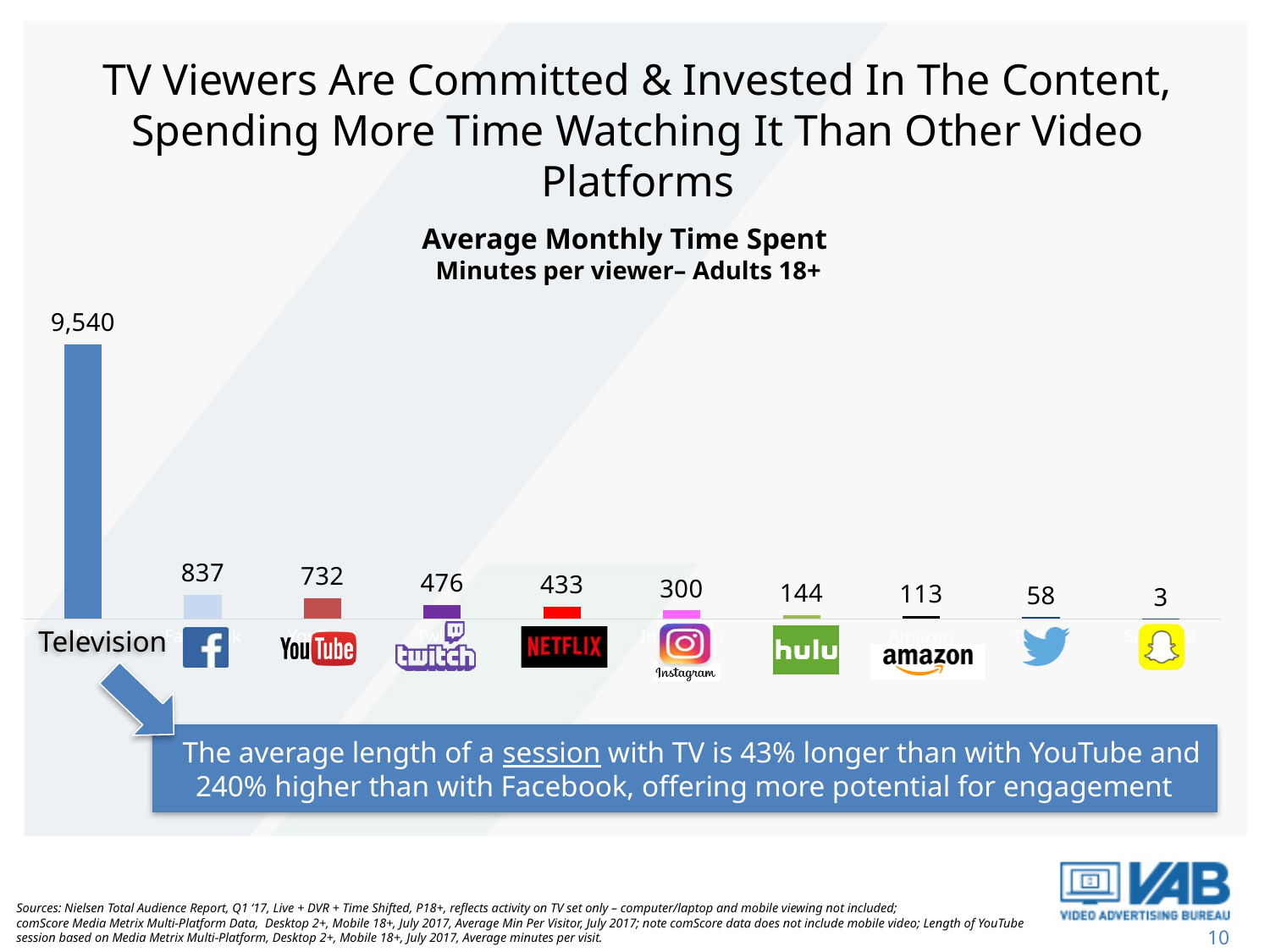
Which platform has the highest average monthly time spent? Television Which has a higher value, Twitch or Netflix? Twitch How many platforms are shown in the chart? 10 Which platform has the lowest average monthly time spent? Snapchat What is the value shown for YouTube? 732 What is the value shown for Netflix? 433 What is the title of the chart? Average Monthly Time Spent What is the difference between the Facebook value and the YouTube value? 105 What is the difference between the Television value and the Facebook value? 8,703 What is the average monthly time spent for Television? 9,540 What type of chart is shown on the slide? Bar chart What is the value shown for Hulu? 144